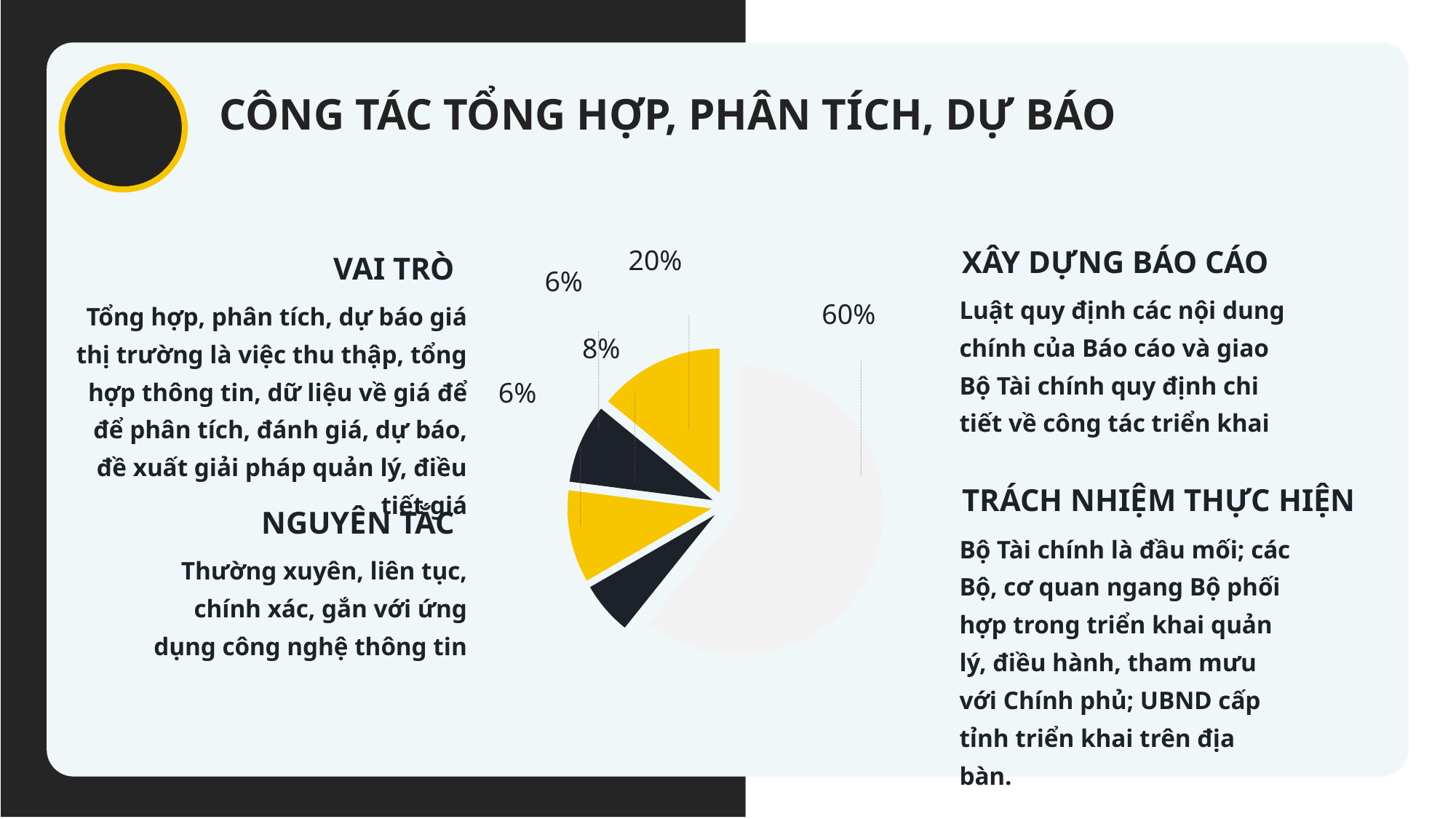
What is the value of the largest slice in the pie chart? 60% What kind of chart is shown on the slide? pie chart What is the value of the smallest slice in the pie chart? 6% How many slices in the pie chart are labelled 6%? 2 What colour is the largest slice of the pie chart? light grey How many slices does the pie chart have? 5 What share of the pie does the light grey slice represent? 60% What is the difference between the largest slice (60%) and the second-largest slice (20%)? 40% What is the value of the second-largest slice in the pie chart? 20% Is the yellow slice at the top of the pie larger or smaller than the dark slice next to it? larger Does the pie chart have a legend? No